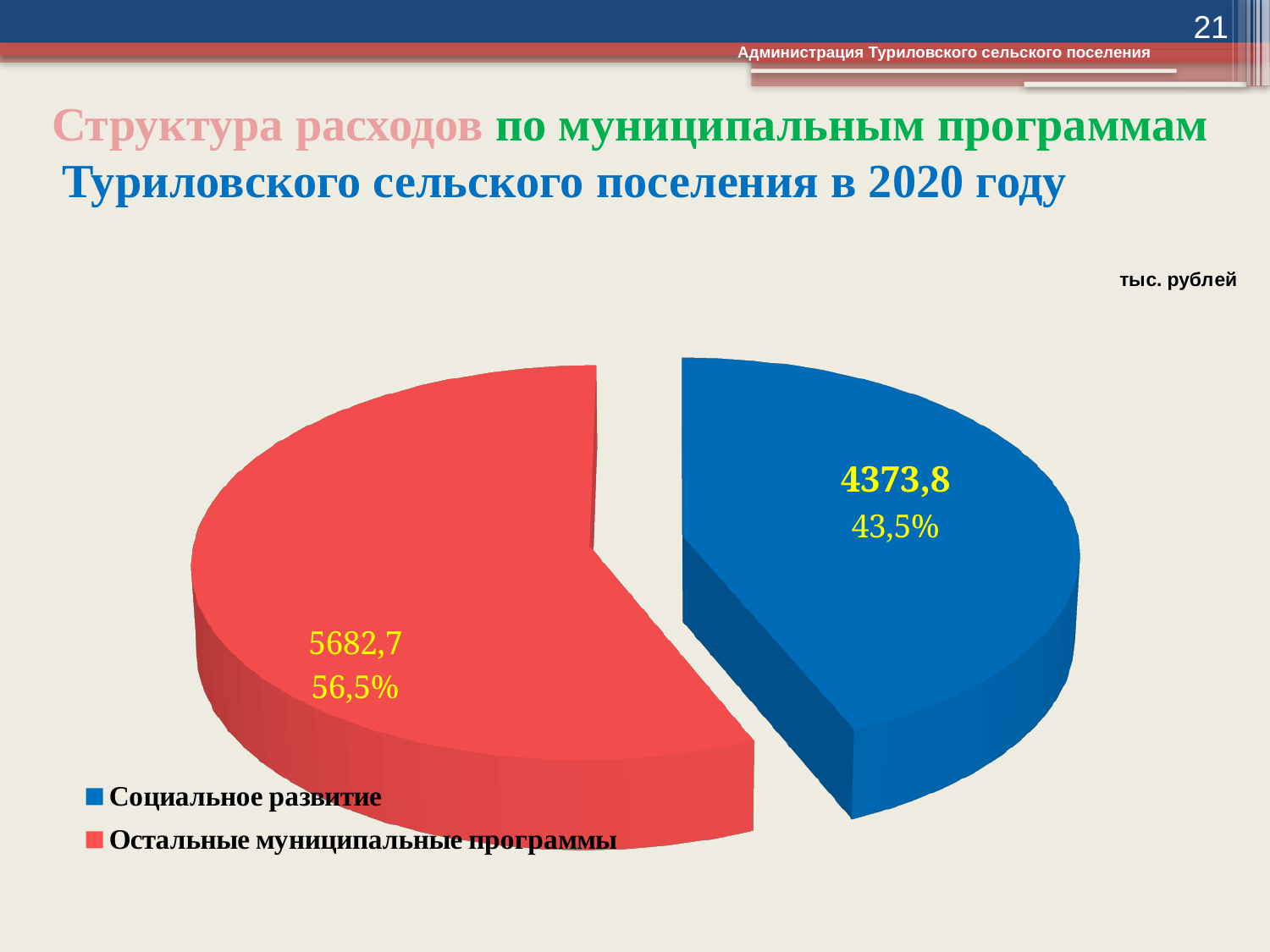
What colour is the slice for Социальное развитие? blue Which is larger: Социальное развитие or Остальные муниципальные программы? Остальные муниципальные программы What share of the pie does Социальное развитие take? 43,5% What is the difference between the values for Остальные муниципальные программы and Социальное развитие? 1308,9 What is the value for Остальные муниципальные программы? 5682,7 What unit is stated for the values on the chart? тыс. рублей What kind of chart is shown on the slide? pie chart How many slices does the pie chart have? 2 What share of the pie does Остальные муниципальные программы take? 56,5% What is the value for Социальное развитие? 4373,8 Which category has the smallest slice? Социальное развитие Which category has the largest slice? Остальные муниципальные программы